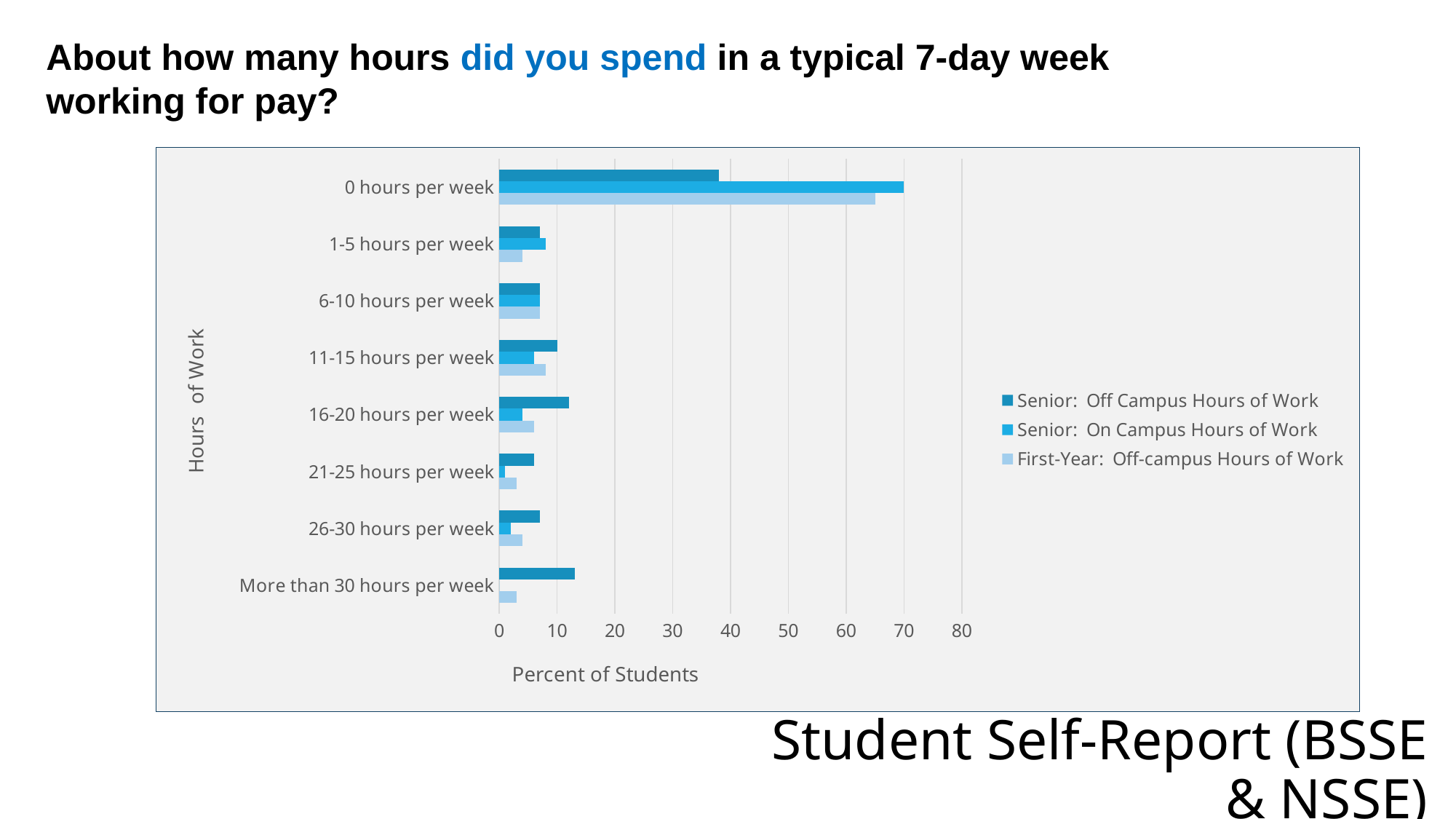
How many series does the legend list? 3 How many hours-of-work categories are shown on the y axis? 8 Is the Senior: Off Campus Hours of Work value for 0 hours per week greater or less than 40? less Which category has the highest value for the First-Year: Off-campus Hours of Work series? 0 hours per week Is the Senior: On Campus Hours of Work value for 0 hours per week greater or less than 60? greater Is the Senior: Off Campus Hours of Work value for More than 30 hours per week greater or less than 10? greater What kind of chart is shown on the slide? bar chart Which category has the highest value for the Senior: Off Campus Hours of Work series? 0 hours per week For 16-20 hours per week, which is larger: Senior: Off Campus Hours of Work or Senior: On Campus Hours of Work? Senior: Off Campus Hours of Work What is the title of the x axis? Percent of Students Which category has the highest value for the Senior: On Campus Hours of Work series? 0 hours per week